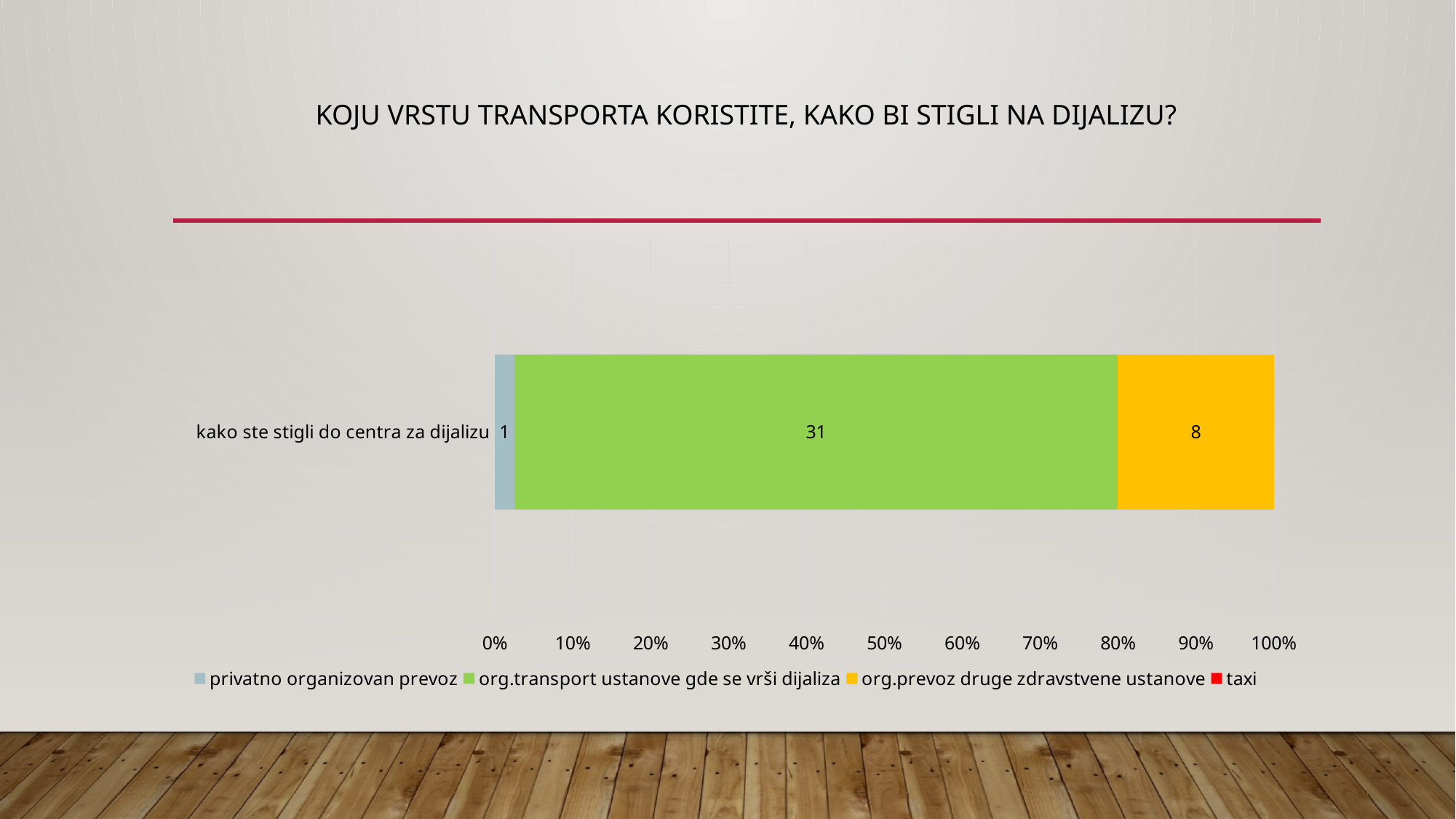
What is the title of the slide? KOJU VRSTU TRANSPORTA KORISTITE, KAKO BI STIGLI NA DIJALIZU? Which of the labelled segments has the smallest value? privatno organizovan prevoz How many categories are shown on the vertical axis? 1 What is the difference between the values for 'org.transport ustanove gde se vrši dijaliza' and 'org.prevoz druge zdravstvene ustanove'? 23 What kind of chart is shown on the slide? stacked bar chart How many series does the legend list? 4 What is the value for 'org.transport ustanove gde se vrši dijaliza'? 31 What is the value for 'org.prevoz druge zdravstvene ustanove'? 8 Which is larger: the value for 'org.prevoz druge zdravstvene ustanove' or for 'privatno organizovan prevoz'? org.prevoz druge zdravstvene ustanove What is the difference between the values for 'org.transport ustanove gde se vrši dijaliza' and 'privatno organizovan prevoz'? 30 Which series has the largest value in the bar? org.transport ustanove gde se vrši dijaliza What is the value for 'privatno organizovan prevoz'? 1